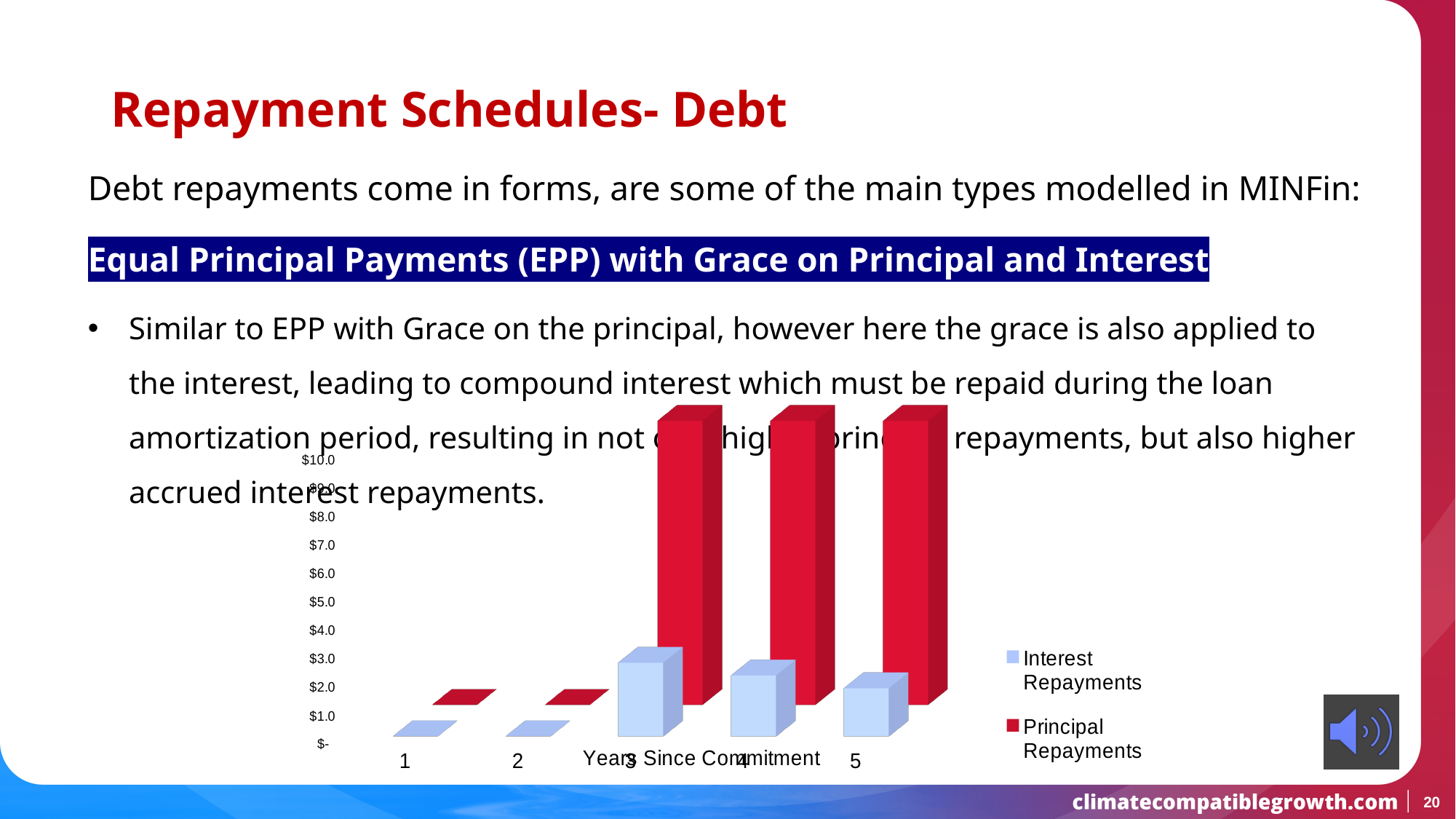
How many series does the chart legend list? 2 What are the two series named in the chart legend? Interest Repayments and Principal Repayments Is the Interest Repayments value for year 5 greater or less than $4.0? less From year 3 to year 5, do the Interest Repayments rise or fall? fall Is the Principal Repayments value for year 3 greater or less than $8.0? greater How many years (categories) are shown on the chart's x axis? 5 What is the title of the chart's x axis? Years Since Commitment In year 4, which is larger: Principal Repayments or Interest Repayments? Principal Repayments Which is larger: Interest Repayments in year 3 or in year 5? year 3 What kind of chart is shown on the slide? bar chart Which year has the highest Interest Repayments? 3 Is the Interest Repayments value for year 3 greater or less than $5.0? less